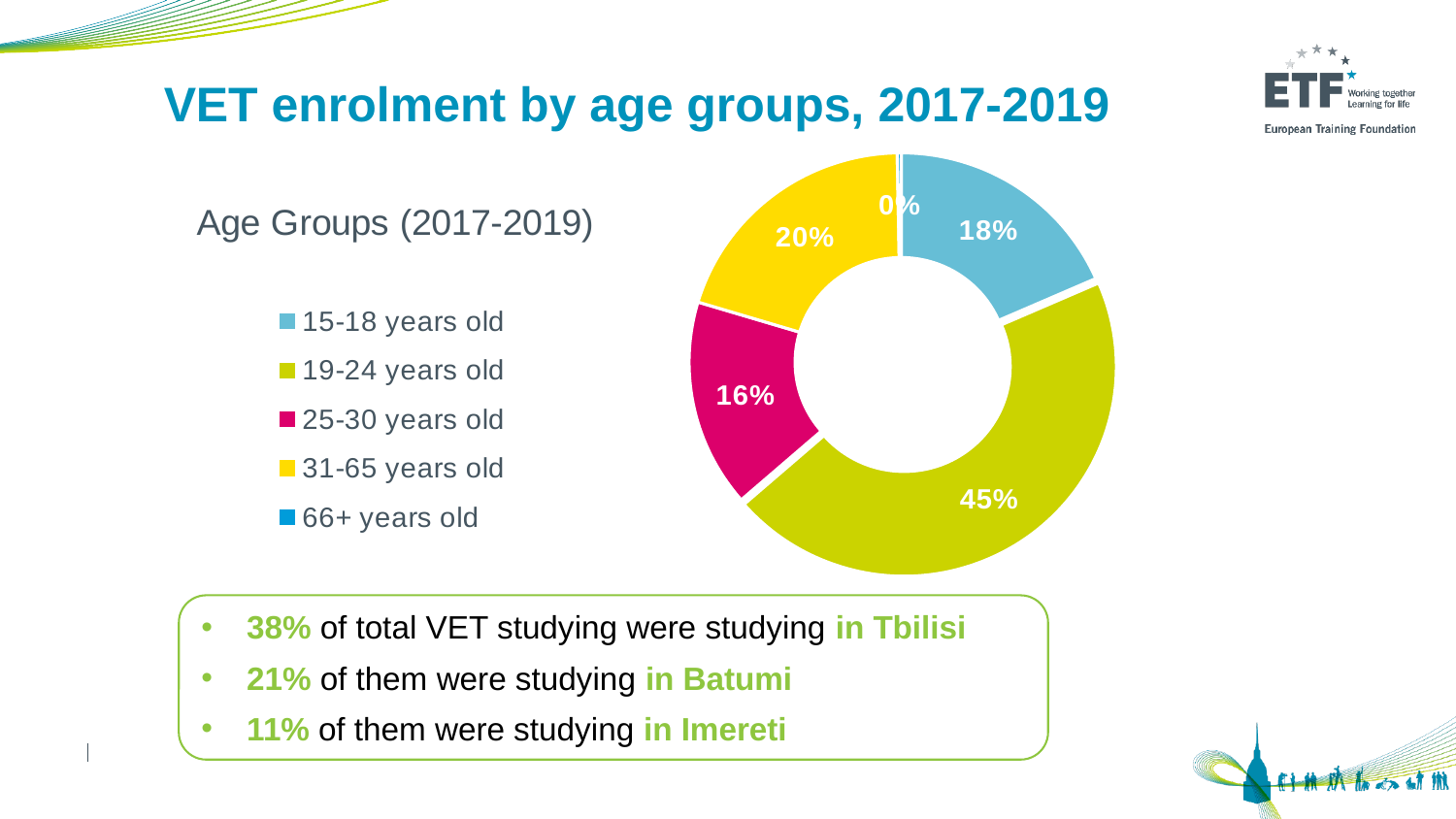
What kind of chart is shown on the slide? Doughnut chart What share of VET enrolment is the 31-65 years old group? 20% How many age groups does the legend list? 5 What share of VET enrolment is the 25-30 years old group? 16% What is the difference in percentage points between the 19-24 years old and 15-18 years old shares? 27 Which age group has the largest share of VET enrolment? 19-24 years old What share of VET enrolment is the 66+ years old group? 0% Which has a larger share, the 31-65 years old group or the 25-30 years old group? 31-65 years old What share of VET enrolment is the 19-24 years old group? 45% What is the chart's title? Age Groups (2017-2019) Which age group has the smallest share of VET enrolment? 66+ years old What share of VET enrolment is the 15-18 years old group? 18%